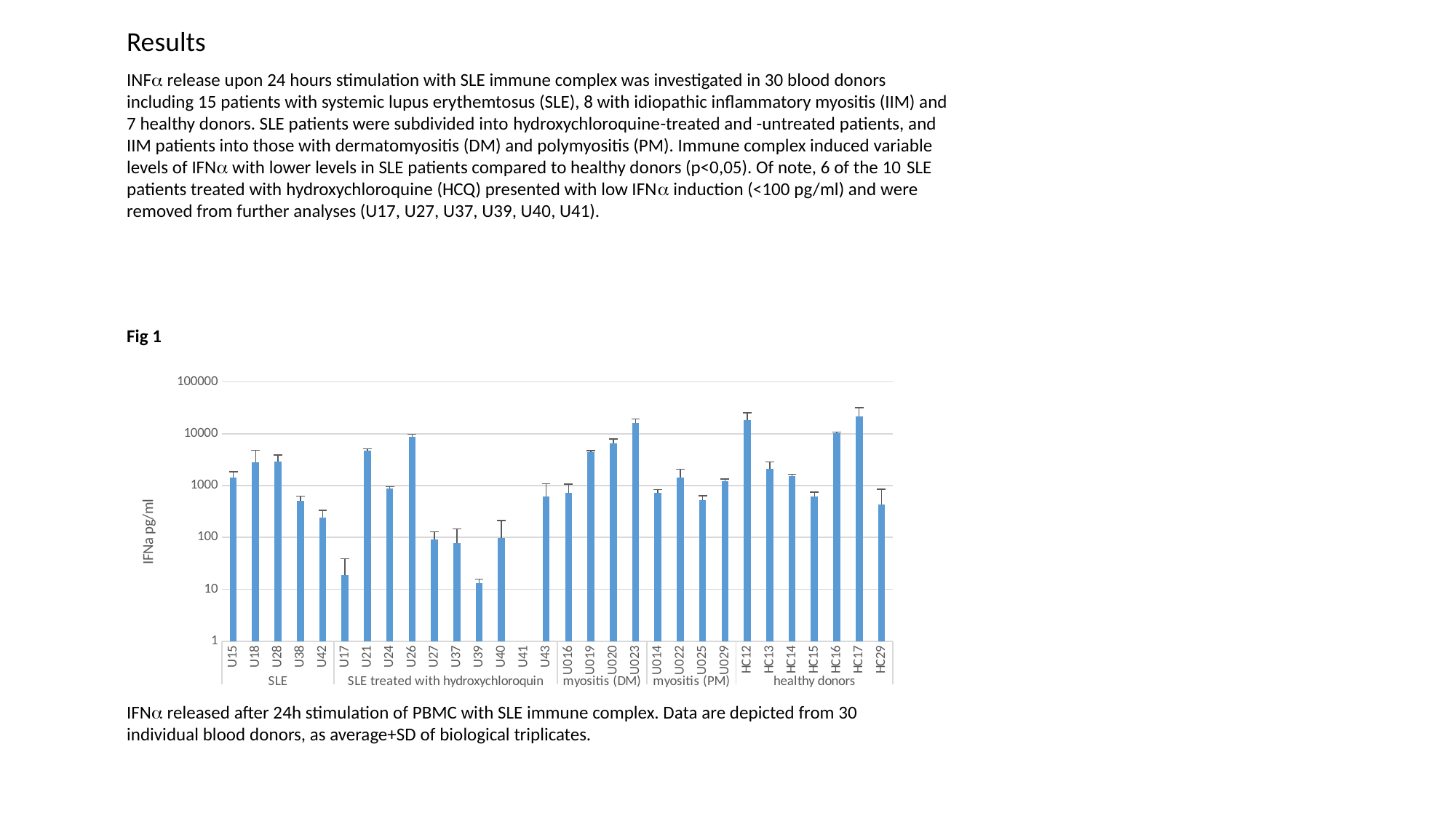
How many donor groups are labelled beneath the x axis of the chart? 5 Which has the larger value, HC15 or HC16? HC16 Is the value for U42 greater or less than 1000? less Is the value for HC17 greater or less than 10000? greater Is the value for U26 greater or less than 1000? greater What is the label on the y axis of the chart? IFNa pg/ml How many donor categories are labelled on the x axis of the chart? 30 Which has the larger value, U26 or U27? U26 What kind of chart is shown in Fig 1? bar chart